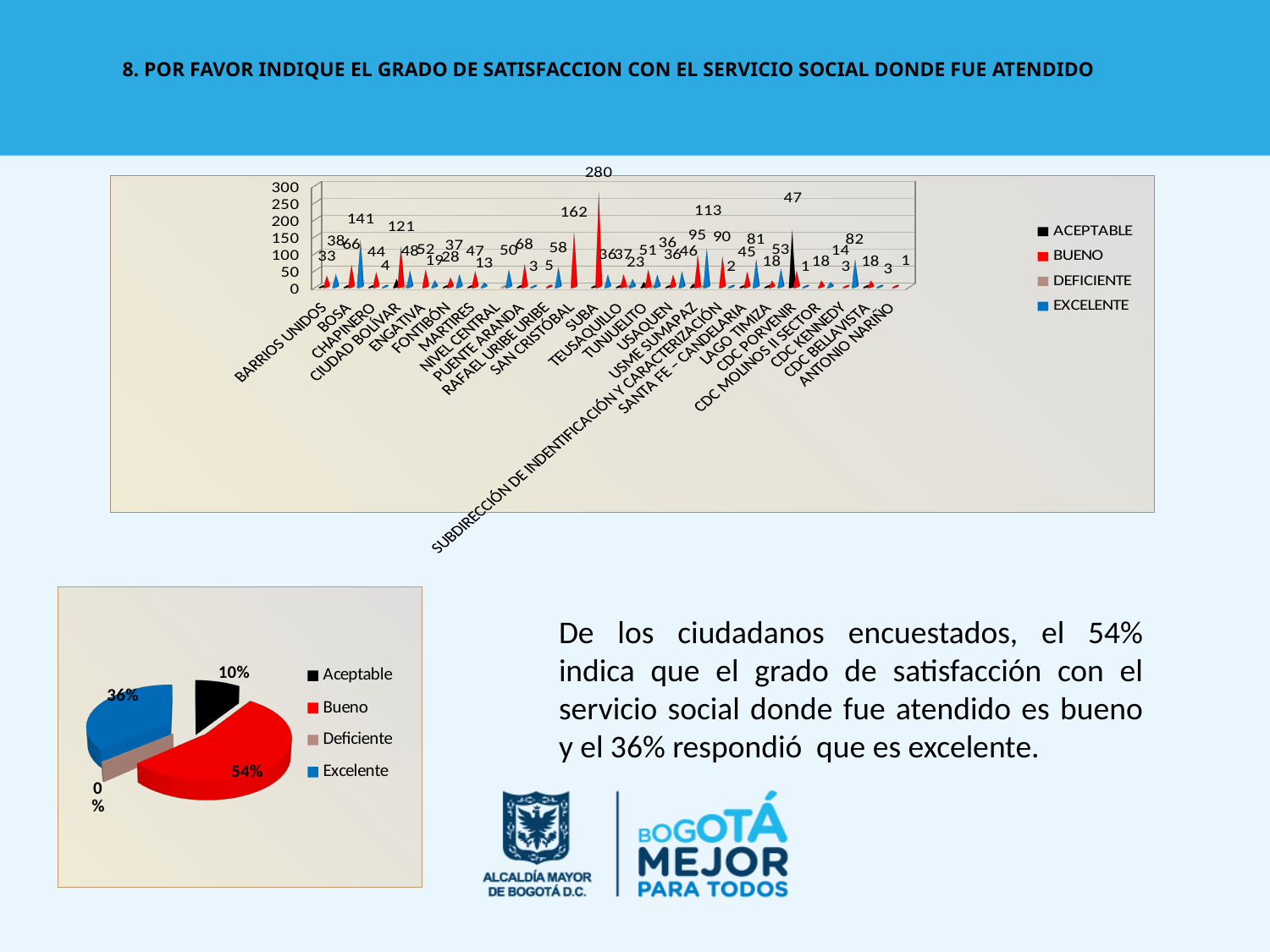
How many series does the legend of the bar chart at the top of the slide list? 4 What kind of chart is shown at the bottom left of the slide? Pie chart In the pie chart at the bottom left, which category has the largest share? Bueno In the bar chart at the top of the slide, is the BUENO value for SUBA greater or less than 250? greater In the pie chart at the bottom left, what percentage is shown for Bueno? 54% In the pie chart at the bottom left, which category has the smallest share? Deficiente In the pie chart at the bottom left, which is larger, the share for Bueno or the share for Excelente? Bueno In the pie chart at the bottom left, what percentage is shown for Aceptable? 10% In the pie chart at the bottom left, what percentage is shown for Excelente? 36% How many categories does the legend of the pie chart at the bottom left list? 4 In the bar chart at the top of the slide, what is the highest value labeled? 280 In the pie chart at the bottom left, what is the difference in percentage points between Bueno and Excelente? 18